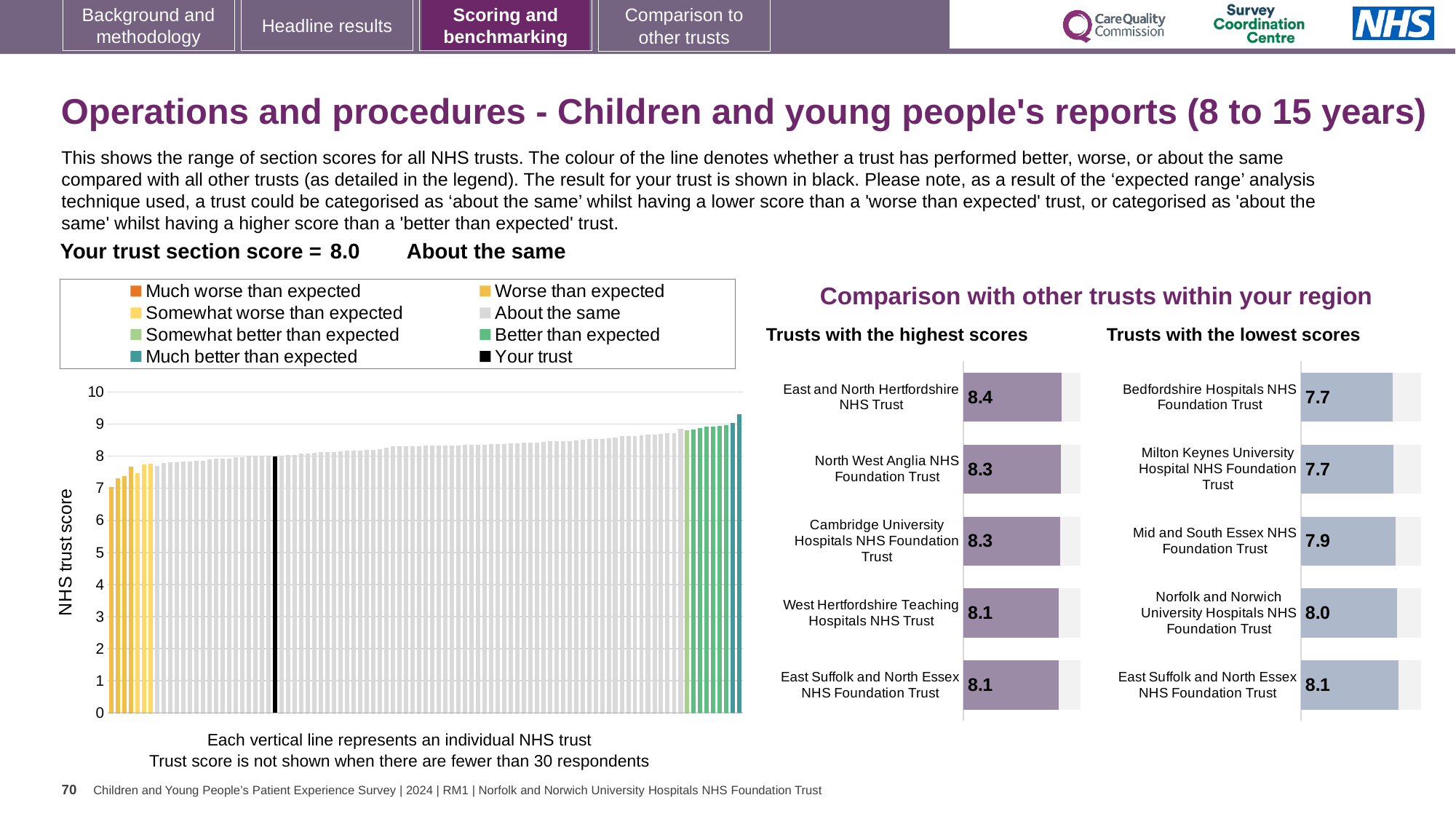
In the 'Trusts with the lowest scores' chart, which has the larger score: Mid and South Essex NHS Foundation Trust or Norfolk and Norwich University Hospitals NHS Foundation Trust? Norfolk and Norwich University Hospitals NHS Foundation Trust In the 'Trusts with the highest scores' chart, how many trusts are shown? 5 In the 'Trusts with the highest scores' chart, what is the score for East and North Hertfordshire NHS Trust? 8.4 In the 'Trusts with the highest scores' chart, what is the difference between the scores of East and North Hertfordshire NHS Trust and West Hertfordshire Teaching Hospitals NHS Trust? 0.3 In the 'Trusts with the highest scores' chart, which trust has the highest score? East and North Hertfordshire NHS Trust In the 'Trusts with the lowest scores' chart, what is the score for Mid and South Essex NHS Foundation Trust? 7.9 In the 'Trusts with the lowest scores' chart, which trust has the highest score? East Suffolk and North Essex NHS Foundation Trust In the 'NHS trust score' chart on the left, is the value of the leftmost (lowest) bar greater or less than 5? greater What kind of chart is the large chart on the left with the y-axis labelled 'NHS trust score'? Bar chart In the 'NHS trust score' chart on the left, do the bar values rise or fall from left to right? Rise How many entries does the legend above the 'NHS trust score' chart list? 8 In the 'NHS trust score' chart on the left, is the value of the rightmost (highest) bar greater or less than 10? less